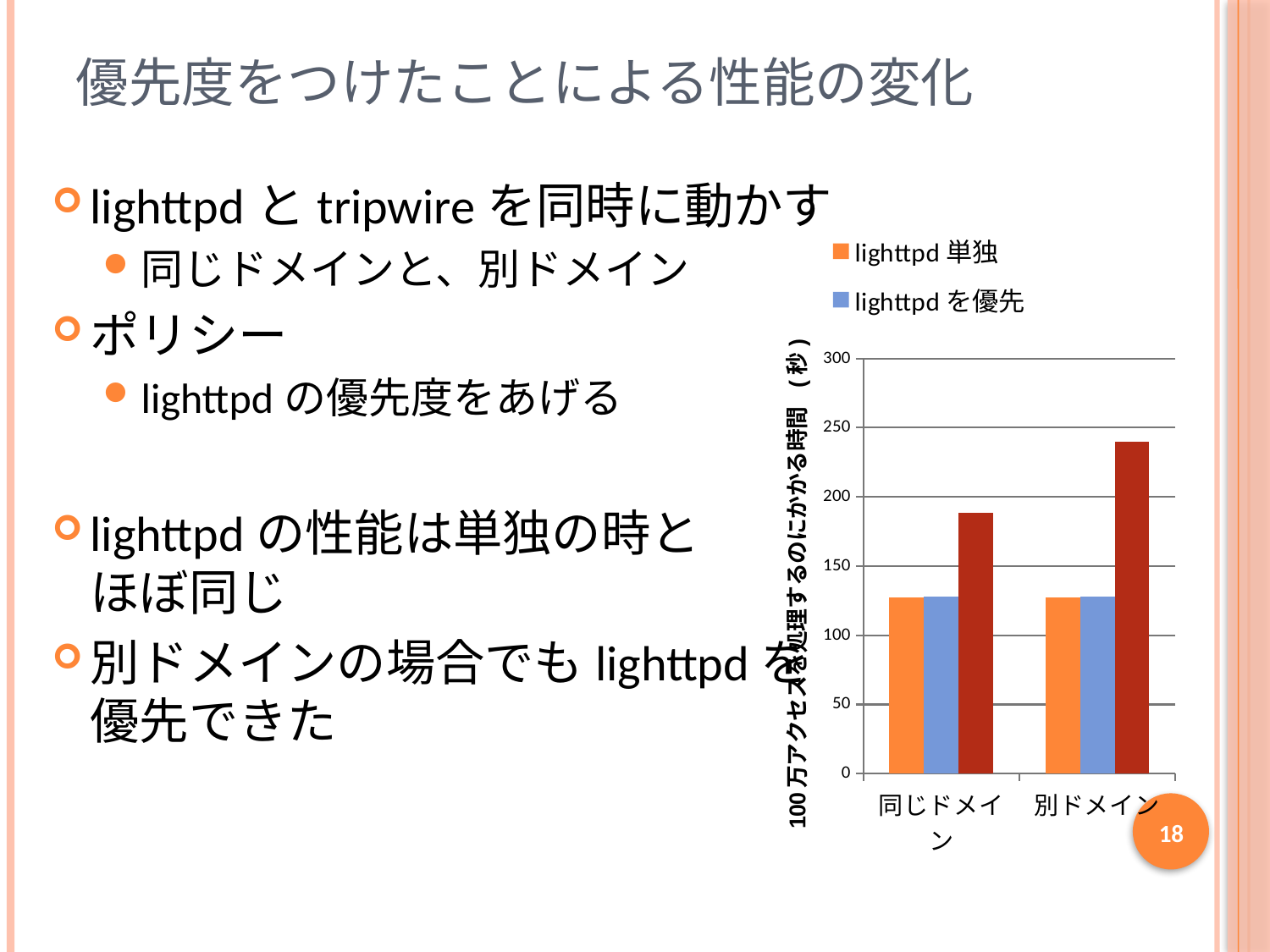
Is the value for lighttpd 単独 in the 同じドメイン category greater or less than 150? less Is the value for lighttpd 単独 in the 別ドメイン category greater or less than 200? less What kind of chart is shown on the slide? bar chart What is the label of the y axis of the chart? 100万アクセスを処理するのにかかる時間（秒） What is the highest tick value shown on the y axis of the chart? 300 What are the two category labels on the x axis of the chart? 同じドメイン and 別ドメイン Is the value for lighttpd を優先 in the 別ドメイン category greater or less than 150? less How many categories are shown on the x axis of the chart? 2 How many series does the chart's legend list? 2 Which colour represents lighttpd を優先 in the chart's legend? blue